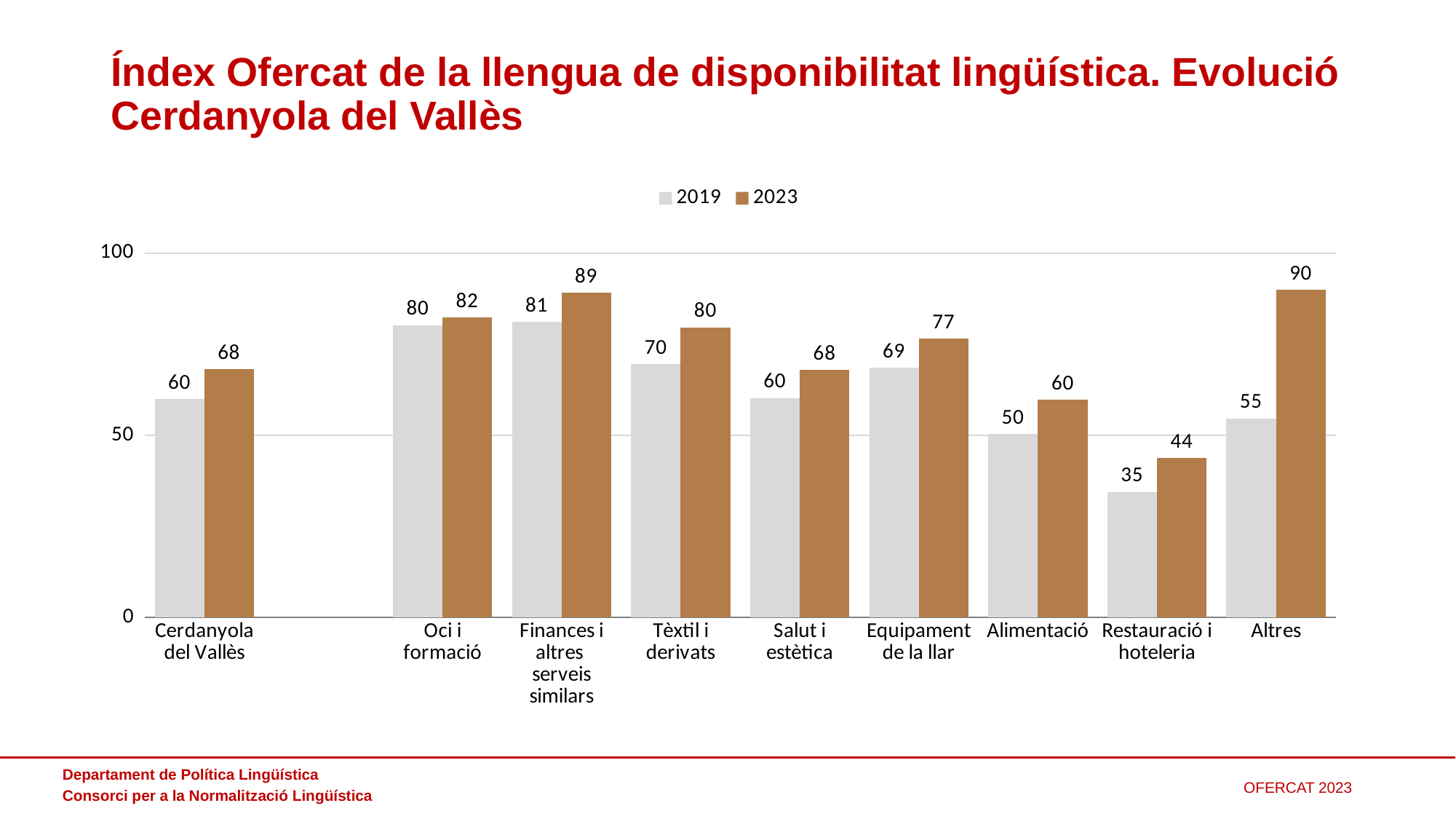
What is the 2019 value for Cerdanyola del Vallès? 60 Which category has the lowest 2019 value? Restauració i hoteleria How many series does the legend list? 2 What is the 2023 value for Finances i altres serveis similars? 89 Which category has the highest 2023 value? Altres What is the difference between the 2023 and 2019 values for Altres? 35 How many categories are shown on the x axis? 9 Is the 2023 value for Restauració i hoteleria greater or less than 50? less Which is larger, the 2023 value for Alimentació or the 2023 value for Salut i estètica? Salut i estètica What kind of chart is shown on the slide? bar chart What is the difference between the 2023 and 2019 values for Cerdanyola del Vallès? 8 What is the 2019 value for Restauració i hoteleria? 35